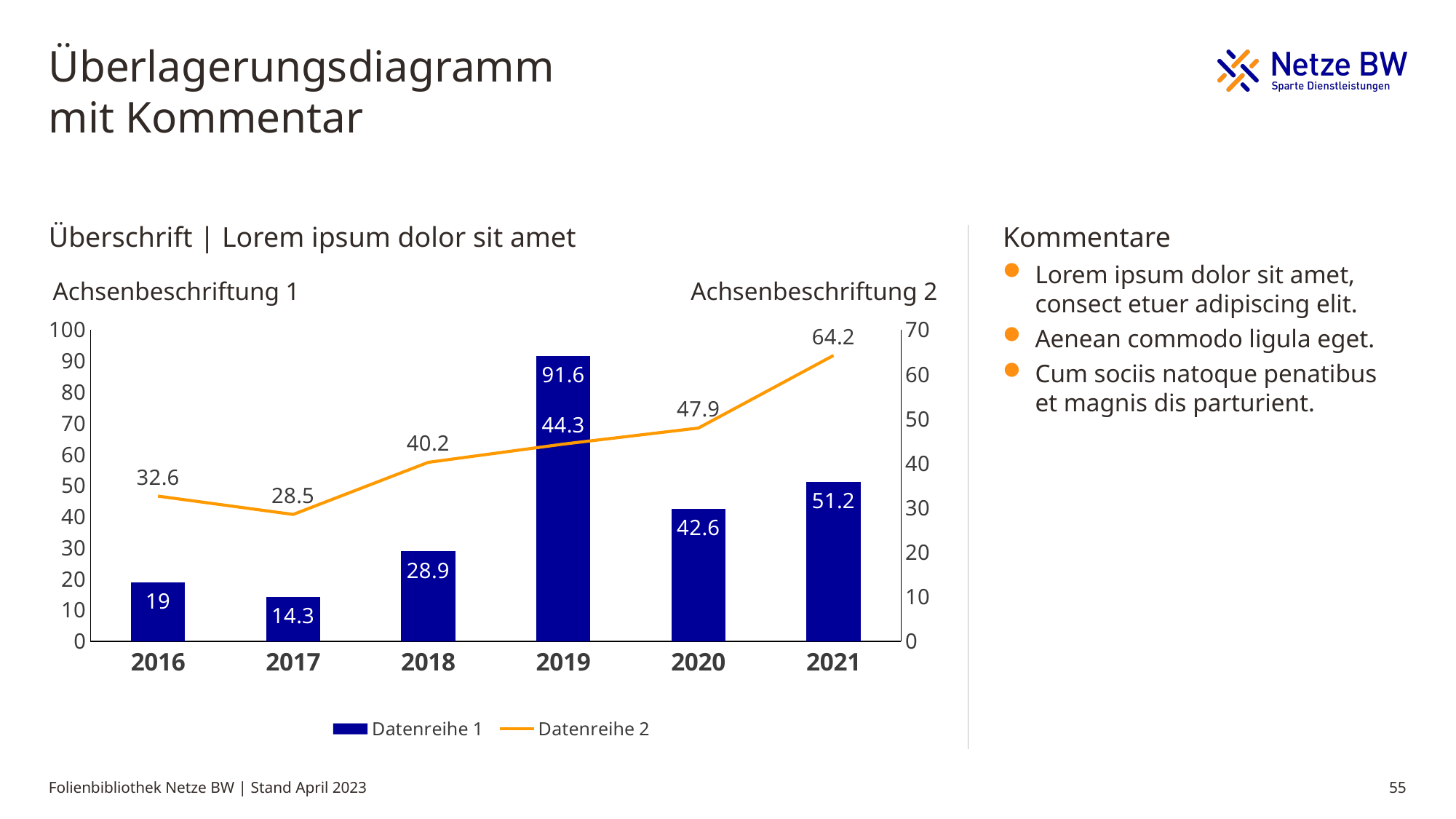
What is the difference between the Datenreihe 1 values for 2021 and 2020? 8.6 What kind of chart is shown on the slide? Combined bar and line chart What is the value of Datenreihe 2 for 2021? 64.2 What is the value of Datenreihe 2 for 2016? 32.6 What is the value of Datenreihe 1 for 2017? 14.3 Which year has the highest value for Datenreihe 1? 2019 Which year has the lowest value for Datenreihe 2? 2017 Which is larger for 2018: the Datenreihe 1 value or the Datenreihe 2 value? Datenreihe 2 What is the value of Datenreihe 1 for 2019? 91.6 How many series does the legend list? 2 Does Datenreihe 2 rise or fall from 2017 to 2021? Rise How many years are shown on the x axis? 6